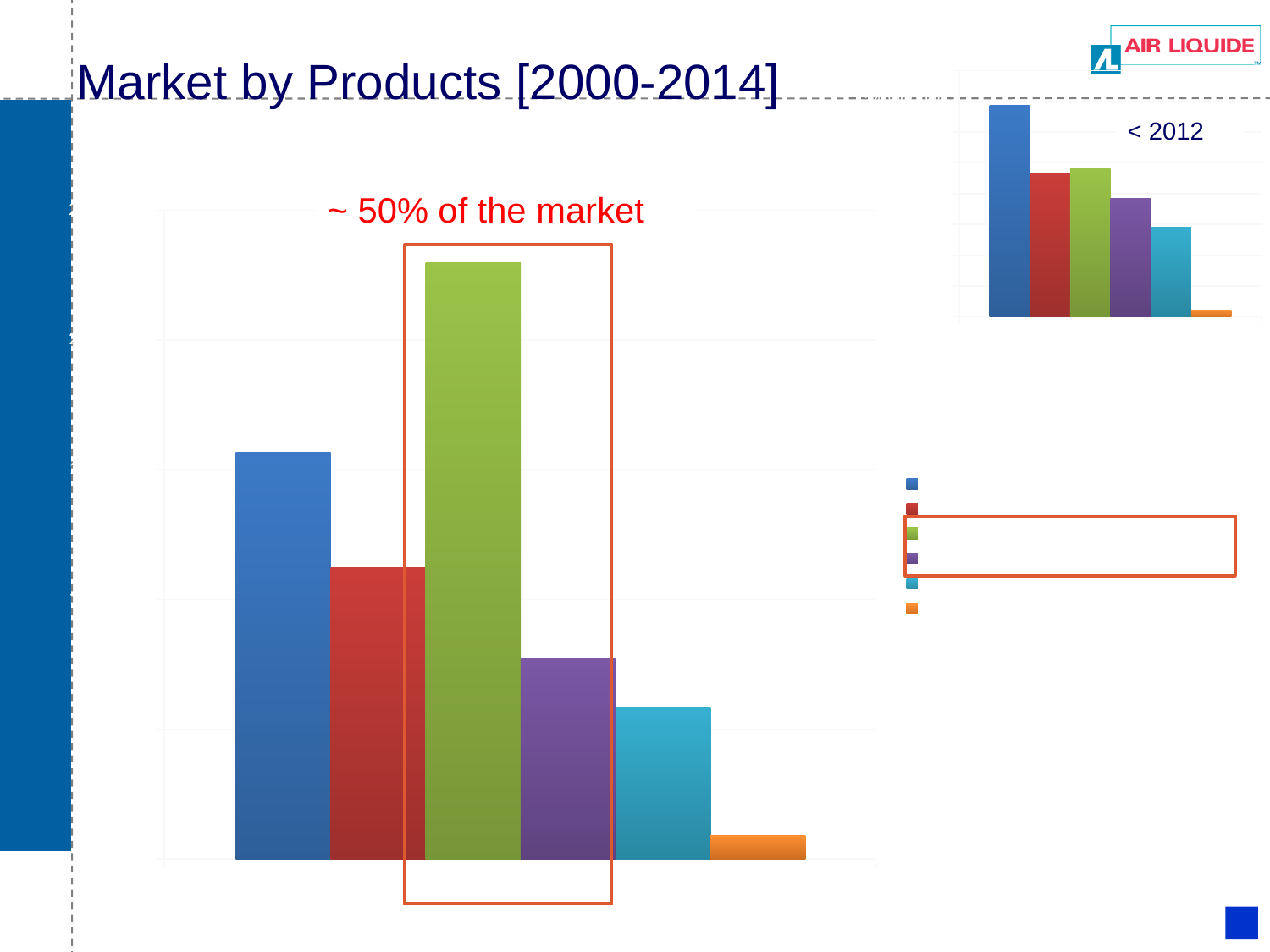
In the large chart on the left, which coloured bar is the tallest? the green bar In the large chart on the left, which is taller, the purple bar or the cyan bar? the purple bar What does the red annotation above the highlighted green bar in the large chart say? ~ 50% of the market What is the title of the slide containing the charts? Market by Products [2000-2014] How many bars does the large chart on the left of the slide show? 6 In the large chart on the left, which coloured bar is the shortest? the orange bar In the small chart at the top right labelled '< 2012', which coloured bar is the tallest? the blue bar How many bars does the small chart at the top right labelled '< 2012' show? 6 What kind of chart is the large chart on the left of the slide? bar chart In the large chart on the left, which is taller, the blue bar or the red bar? the blue bar In the small chart at the top right labelled '< 2012', which coloured bar is the shortest? the orange bar